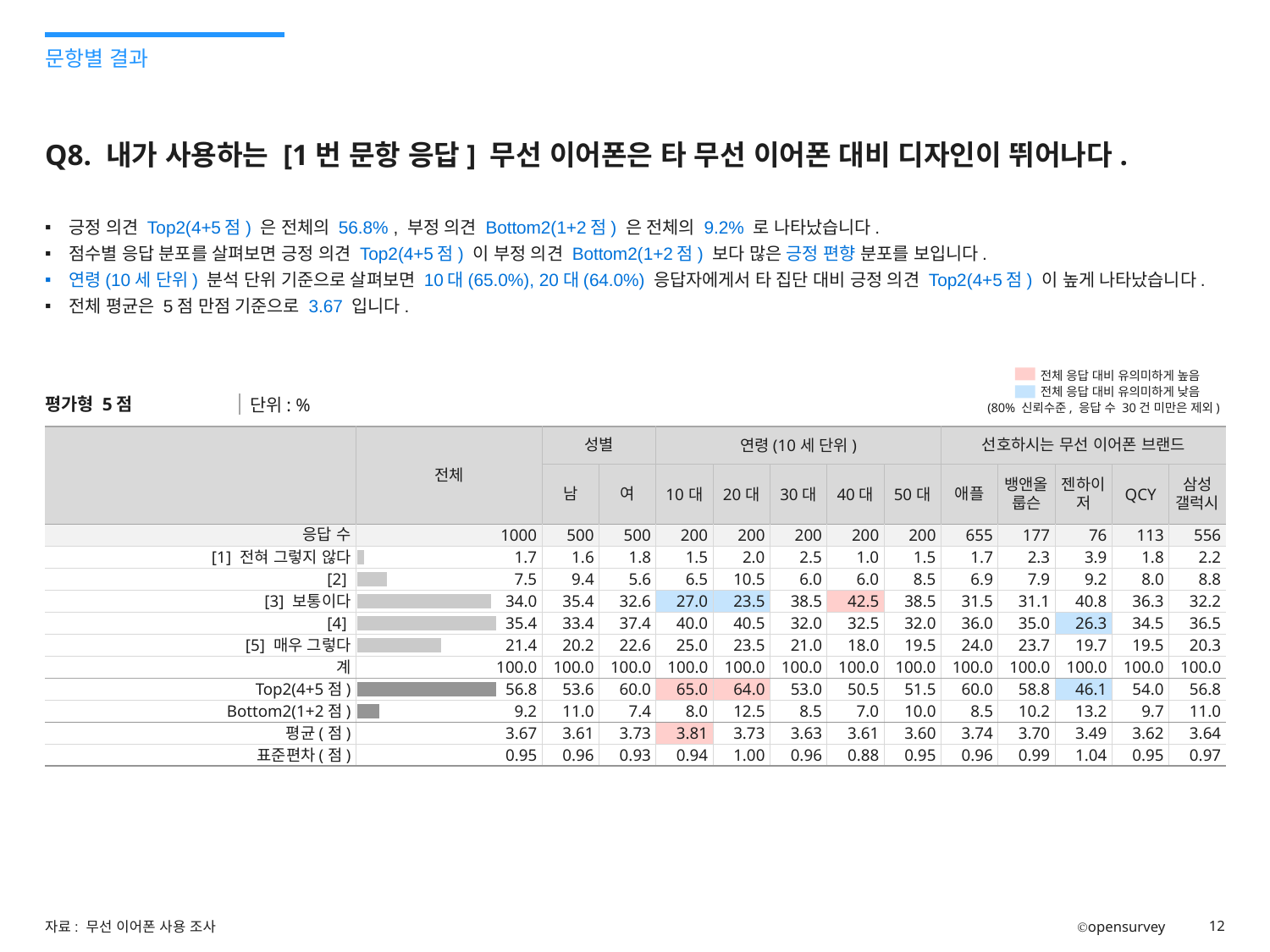
What type of chart is embedded in the 전체 column of the table? bar chart What is the 전체 value for Bottom2(1+2 점)? 9.2 What unit is stated for the values in the table? % What is the 전체 value for [5] 매우 그렇다? 21.4 Which is larger in the 전체 column, Top2(4+5 점) or Bottom2(1+2 점)? Top2(4+5 점) What is the difference between the 전체 values for [4] and [3] 보통이다? 1.4 What is the total of the 전체 values for the five score categories [1] to [5]? 100.0 What is the 전체 value for [4]? 35.4 What is the 전체 value for Top2(4+5 점)? 56.8 Among the five score categories [1] to [5], which has the lowest 전체 value? [1] 전혀 그렇지 않다 How many score categories ([1] through [5]) are shown with bars in the 전체 column? 5 Among the five score categories [1] to [5], which has the highest 전체 value? [4]